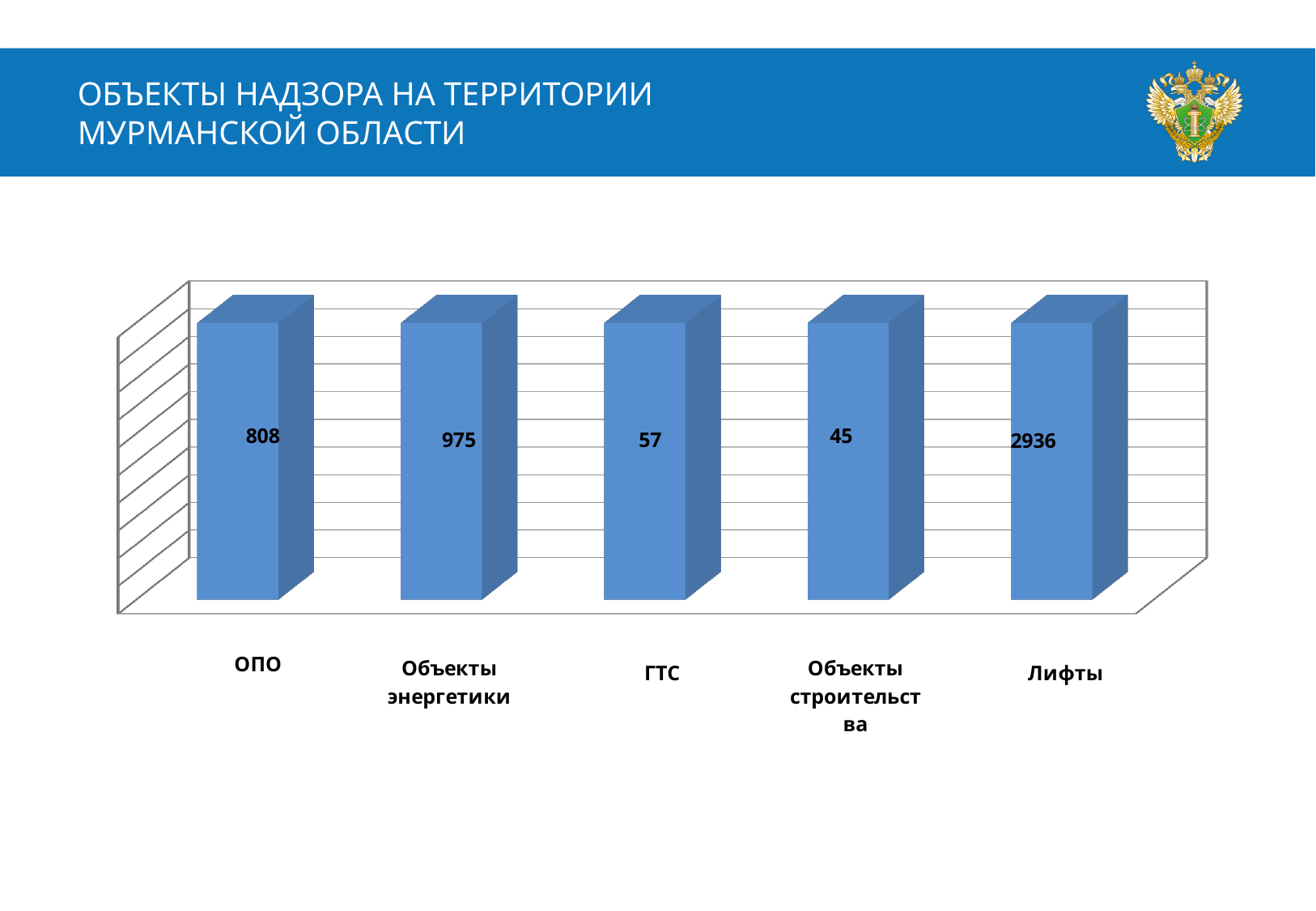
Which category has the lowest value according to the data labels? Объекты строительства What value is shown for ОПО? 808 Which has a larger value, ОПО or Объекты энергетики? Объекты энергетики What is the difference between the values for Объекты энергетики and ОПО? 167 What value is shown for ГТС? 57 Which category has the highest value according to the data labels? Лифты What is the difference between the values for ГТС and Объекты строительства? 12 What kind of chart is shown on the slide? Bar chart What value is shown for Лифты? 2936 What value is shown for Объекты строительства? 45 How many categories are shown in the chart? 5 What value is shown for Объекты энергетики? 975